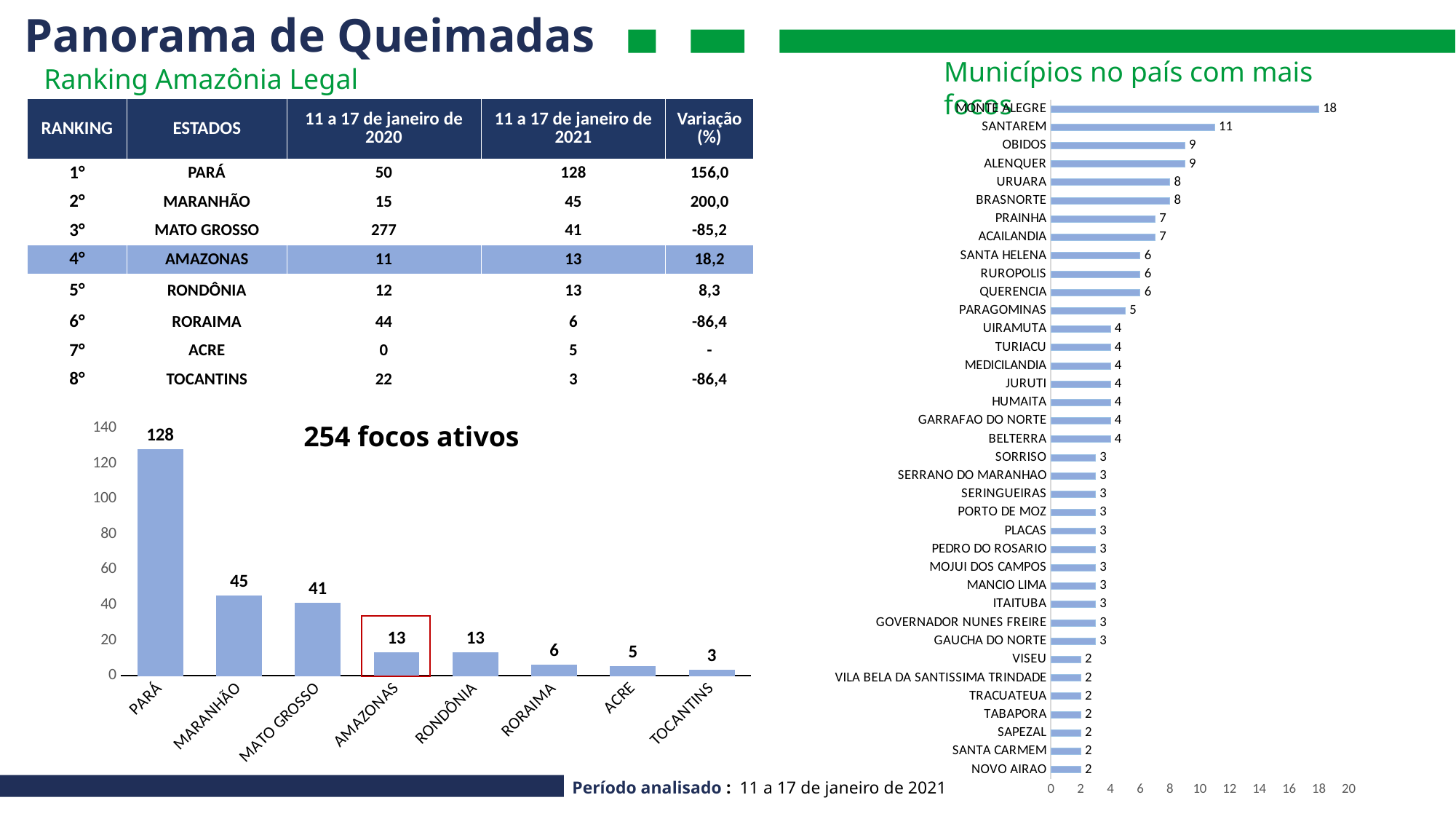
In the '254 focos ativos' chart, which state has the lowest value? TOCANTINS In the '254 focos ativos' chart, do the values rise or fall from left to right? fall In the '254 focos ativos' chart, what is the value for PARÁ? 128 In the 'Municípios no país com mais focos' chart, which municipality has the highest value? MONTE ALEGRE How many states are shown in the '254 focos ativos' chart? 8 In the 'Municípios no país com mais focos' chart, what is the value for SANTAREM? 11 In the '254 focos ativos' chart, what is the value for RONDÔNIA? 13 In the 'Municípios no país com mais focos' chart, what is the difference between MONTE ALEGRE and OBIDOS? 9 In the '254 focos ativos' chart, what is the difference between PARÁ and MARANHÃO? 83 In the 'Municípios no país com mais focos' chart, what is the value for PARAGOMINAS? 5 What kind of chart is the '254 focos ativos' chart? bar chart In the '254 focos ativos' chart, which is larger, MATO GROSSO or MARANHÃO? MARANHÃO